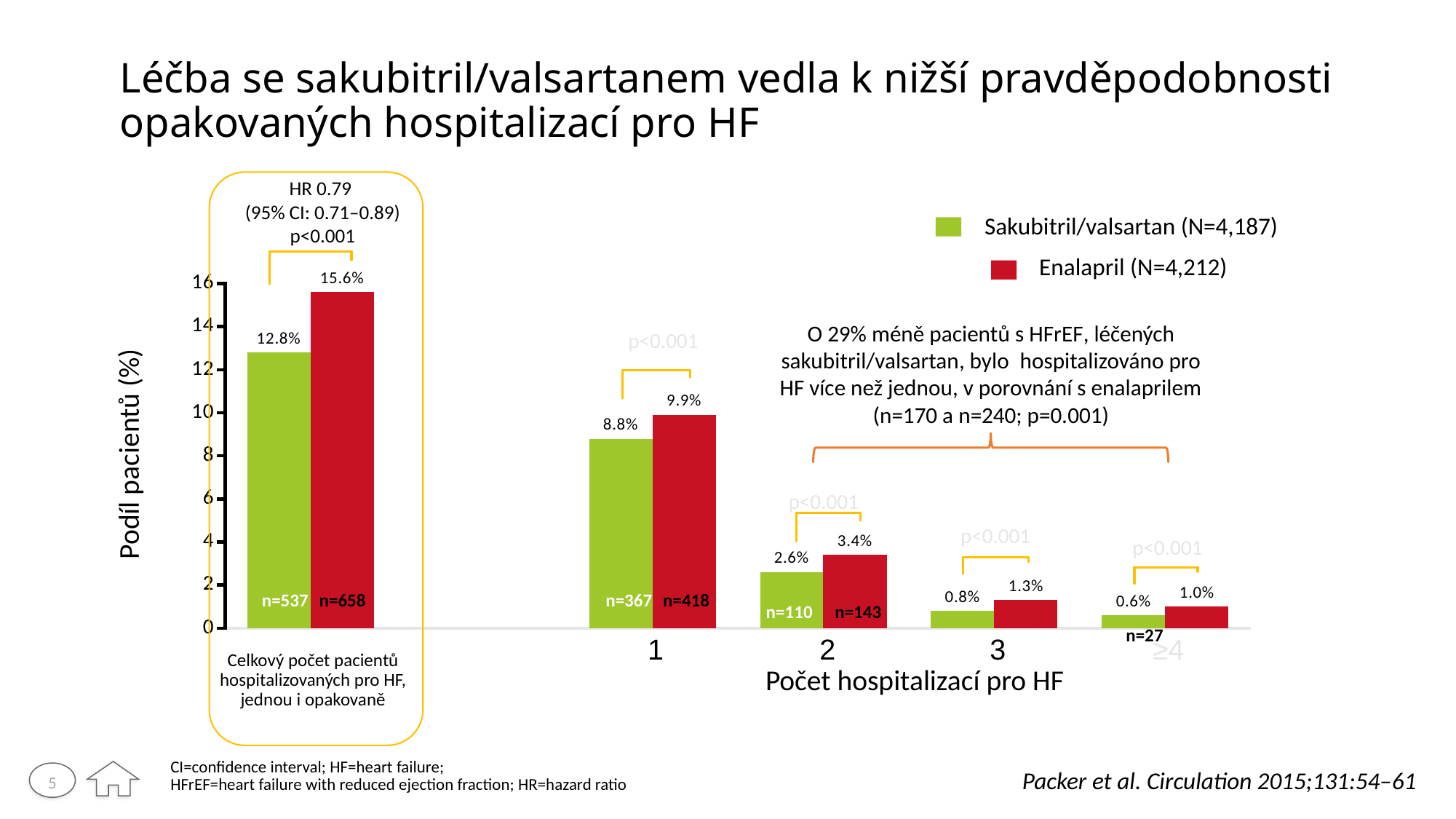
What is the value for Enalapril in the category 'Celkový počet pacientů hospitalizovaných pro HF, jednou i opakovaně'? 15.6% Which series has the higher value at 1 hospitalization for HF, Sakubitril/valsartan or Enalapril? Enalapril What is the difference between Enalapril and Sakubitril/valsartan in the total category (all patients hospitalized for HF once or repeatedly)? 2.8% What is the value for Enalapril at 2 hospitalizations for HF? 3.4% Among the categories 1, 2, 3 and ≥4 hospitalizations, which has the lowest value for Enalapril? ≥4 What is the difference between Enalapril and Sakubitril/valsartan at 3 hospitalizations for HF? 0.5% How many series does the legend list? 2 What is the N given in the legend for the Enalapril series? N=4,212 What type of chart is shown on the slide? bar chart What is the value for Sakubitril/valsartan at 1 hospitalization for HF? 8.8% What is the value for Sakubitril/valsartan at ≥4 hospitalizations for HF? 0.6% Do the values for Sakubitril/valsartan rise or fall as the number of hospitalizations for HF increases from 1 to ≥4? fall